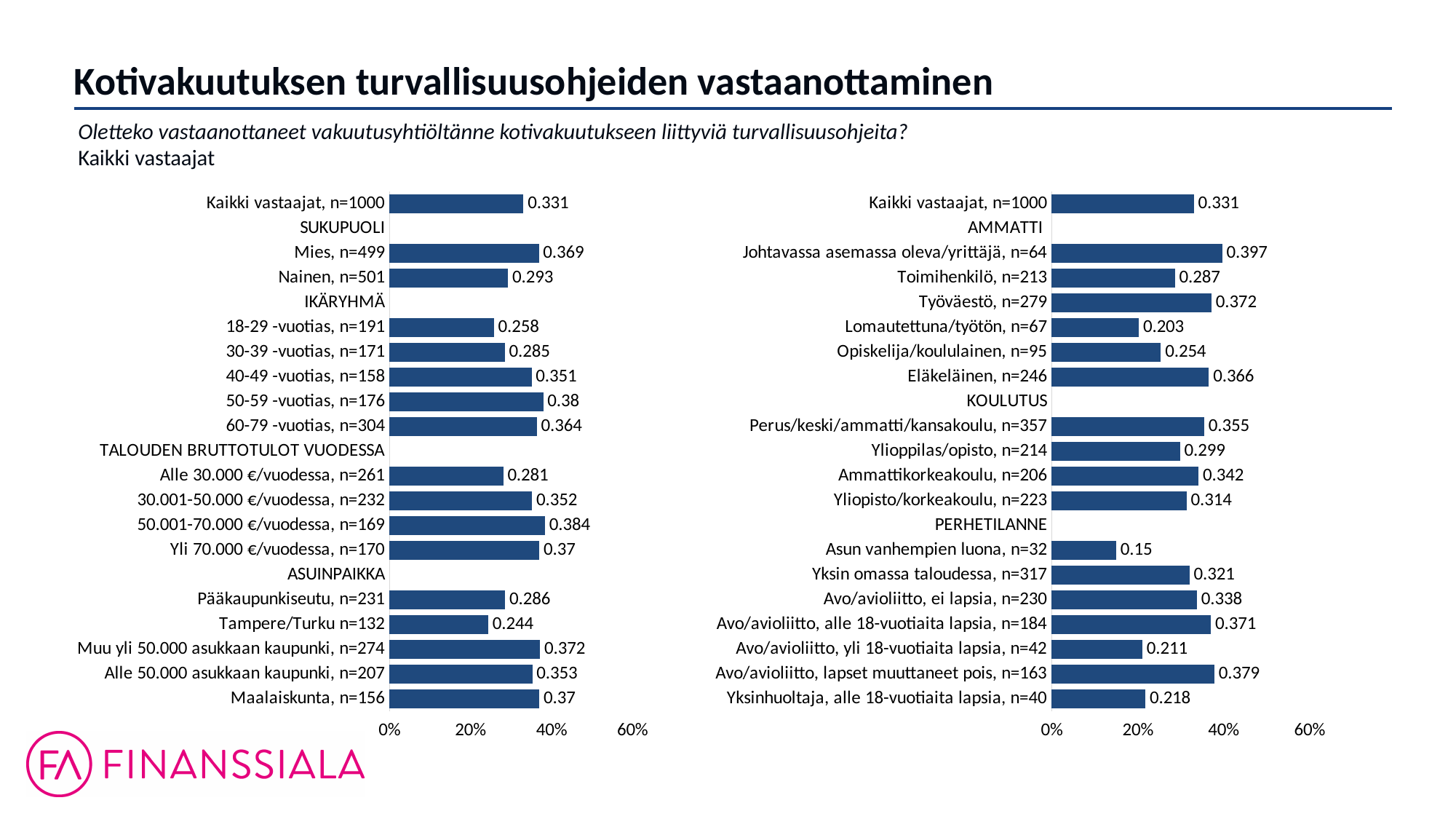
In the right chart, which is larger: the value for Toimihenkilö, n=213 or Työväestö, n=279? Työväestö, n=279 In the right chart, which category has the lowest value? Asun vanhempien luona, n=32 In the left chart, what is the value for Kaikki vastaajat, n=1000? 0.331 In the left chart, which category has the lowest value? Tampere/Turku n=132 In the left chart, how many bars are plotted? 17 In the right chart, what is the difference between the values for Lomautettuna/työtön, n=67 and Opiskelija/koululainen, n=95? 0.051 In the left chart, what is the value for Mies, n=499? 0.369 In the right chart, which category has the highest value? Johtavassa asemassa oleva/yrittäjä, n=64 In the left chart, which category has the highest value? 50.001-70.000 €/vuodessa, n=169 In the left chart, what is the difference between the values for Mies, n=499 and Nainen, n=501? 0.076 In the right chart, what is the value for Eläkeläinen, n=246? 0.366 What kind of chart is shown on the left side of the slide? Bar chart